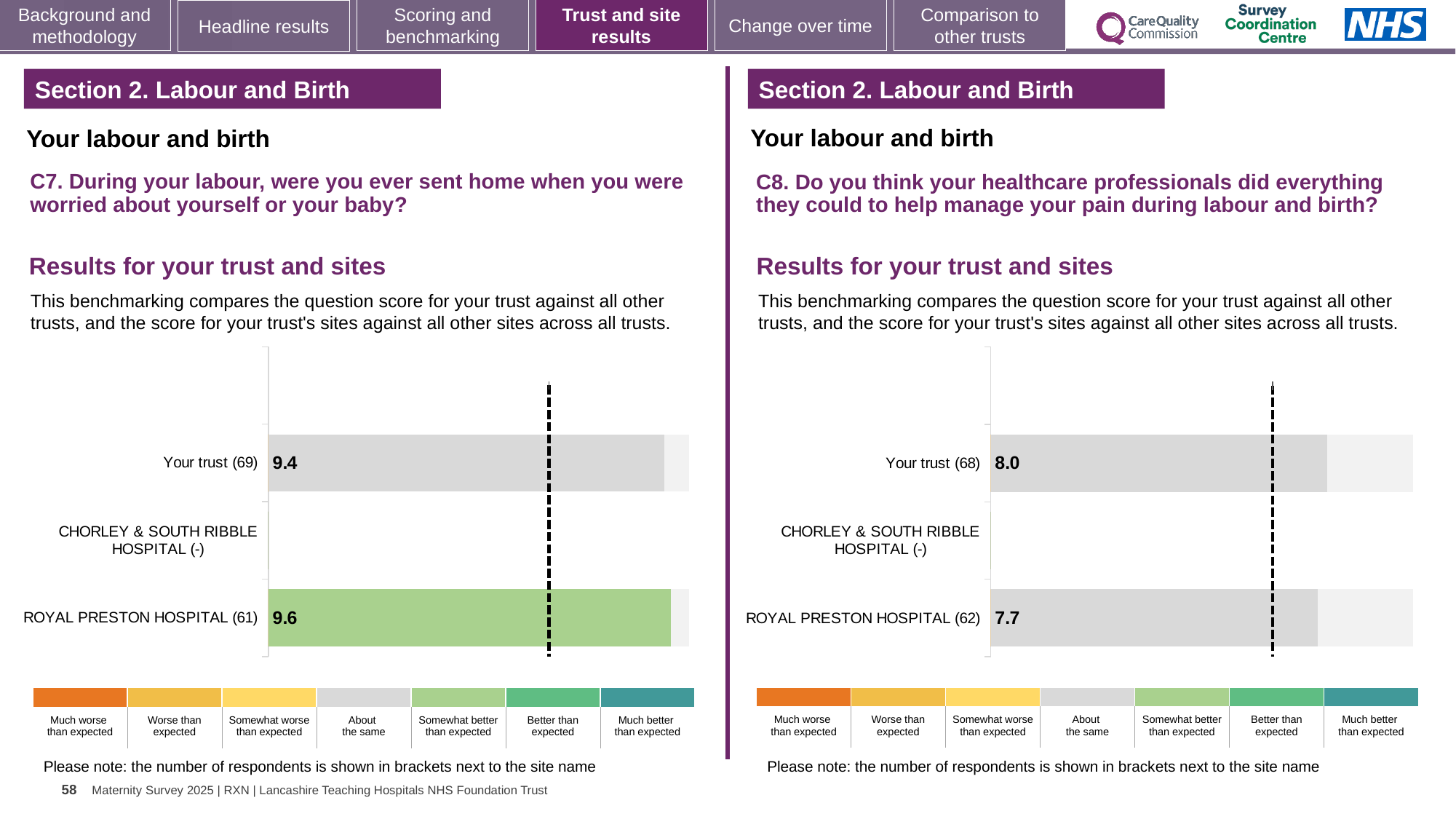
In the left chart (C7), what is the score for Your trust? 9.4 In the right chart (C8), what is the score for ROYAL PRESTON HOSPITAL? 7.7 In the left chart (C7), what is the score for ROYAL PRESTON HOSPITAL? 9.6 In the left chart (C7), which has the higher score, Your trust or ROYAL PRESTON HOSPITAL? ROYAL PRESTON HOSPITAL In the right chart (C8), which has the higher score, Your trust or ROYAL PRESTON HOSPITAL? Your trust In the left chart (C7), what is the difference between the ROYAL PRESTON HOSPITAL score and the Your trust score? 0.2 In the right chart (C8), what is the score for Your trust? 8.0 In the right chart (C8), how many respondents are shown in brackets for Your trust? 68 In the left chart (C7), how many respondents are shown in brackets for ROYAL PRESTON HOSPITAL? 61 In the left chart (C7), which benchmark category does the green bar for ROYAL PRESTON HOSPITAL correspond to in the legend? Somewhat better than expected In the right chart (C8), what is the difference between the Your trust score and the ROYAL PRESTON HOSPITAL score? 0.3 What kind of chart is used on the left side of the slide (C7)? Bar chart